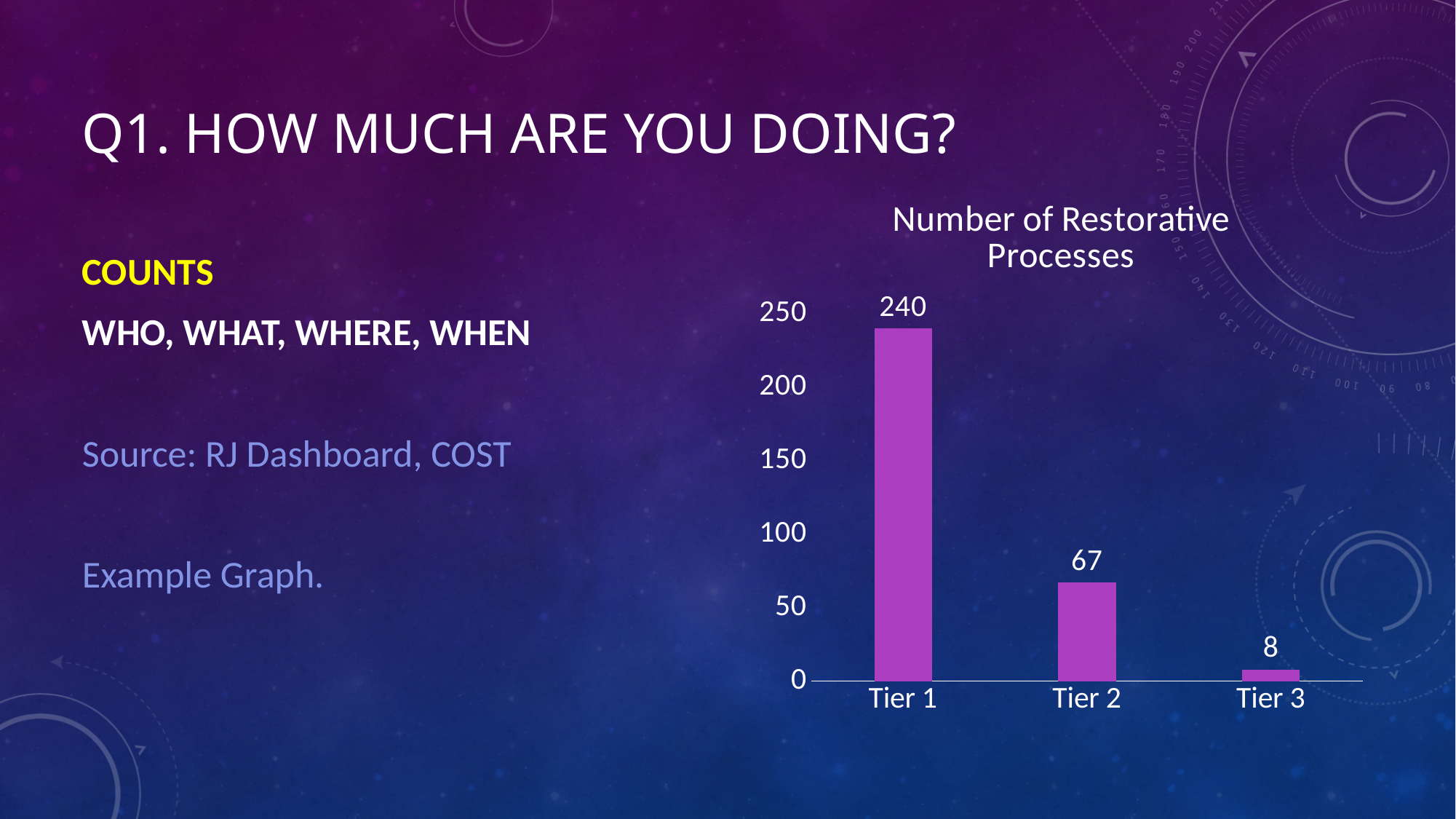
What is the value for Tier 1? 240 What kind of chart is shown on the slide? bar chart Which tier has the highest number of restorative processes? Tier 1 Is the value for Tier 1 greater or less than 200? greater What is the title of the chart? Number of Restorative Processes Which is larger, the value for Tier 2 or the value for Tier 3? Tier 2 What is the difference between the values for Tier 2 and Tier 3? 59 What is the value for Tier 2? 67 What is the difference between the values for Tier 1 and Tier 2? 173 How many categories are shown on the x axis? 3 What is the value for Tier 3? 8 Which tier has the lowest number of restorative processes? Tier 3